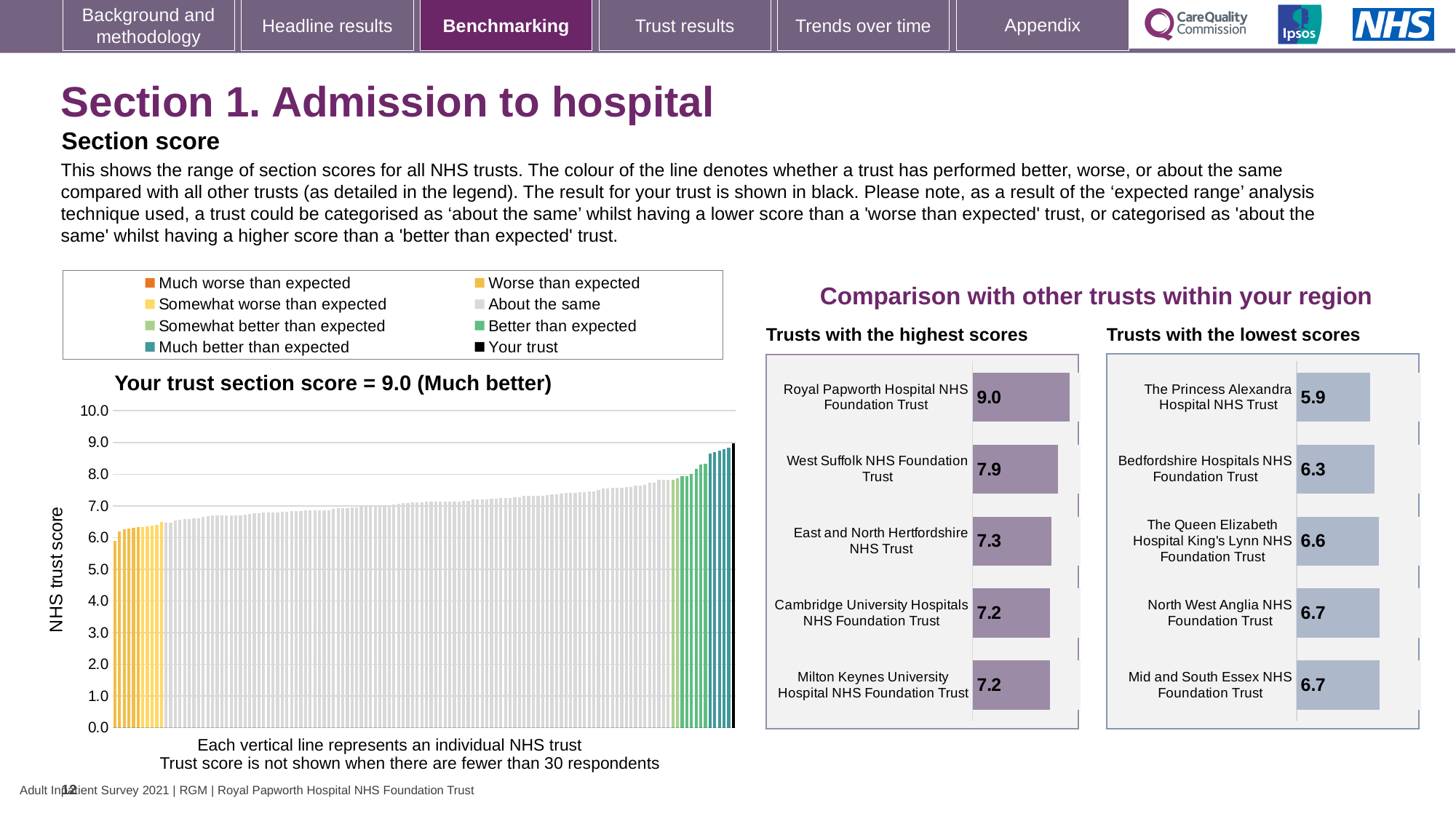
In the 'Your trust section score' chart, how many entries does the legend list? 8 In the 'Trusts with the highest scores' chart, which trust has the highest score? Royal Papworth Hospital NHS Foundation Trust In the 'Trusts with the highest scores' chart, how many trusts are shown? 5 In the 'Trusts with the lowest scores' chart, which has the larger score: Bedfordshire Hospitals NHS Foundation Trust or The Queen Elizabeth Hospital King's Lynn NHS Foundation Trust? The Queen Elizabeth Hospital King's Lynn NHS Foundation Trust In the 'Trusts with the highest scores' chart, what is the difference between the scores of Royal Papworth Hospital NHS Foundation Trust and West Suffolk NHS Foundation Trust? 1.1 In the 'Trusts with the highest scores' chart, what is the score for West Suffolk NHS Foundation Trust? 7.9 In the 'Your trust section score' chart, what is the label on the vertical axis? NHS trust score In the 'Your trust section score' chart, do the bar values rise or fall from left to right? rise In the 'Your trust section score' chart, what is the section score for your trust? 9.0 In the 'Trusts with the lowest scores' chart, which trust has the lowest score? The Princess Alexandra Hospital NHS Trust In the 'Your trust section score' chart, what kind of chart is shown? bar chart In the 'Your trust section score' chart, is the value of the leftmost bar greater or less than 7.0? less